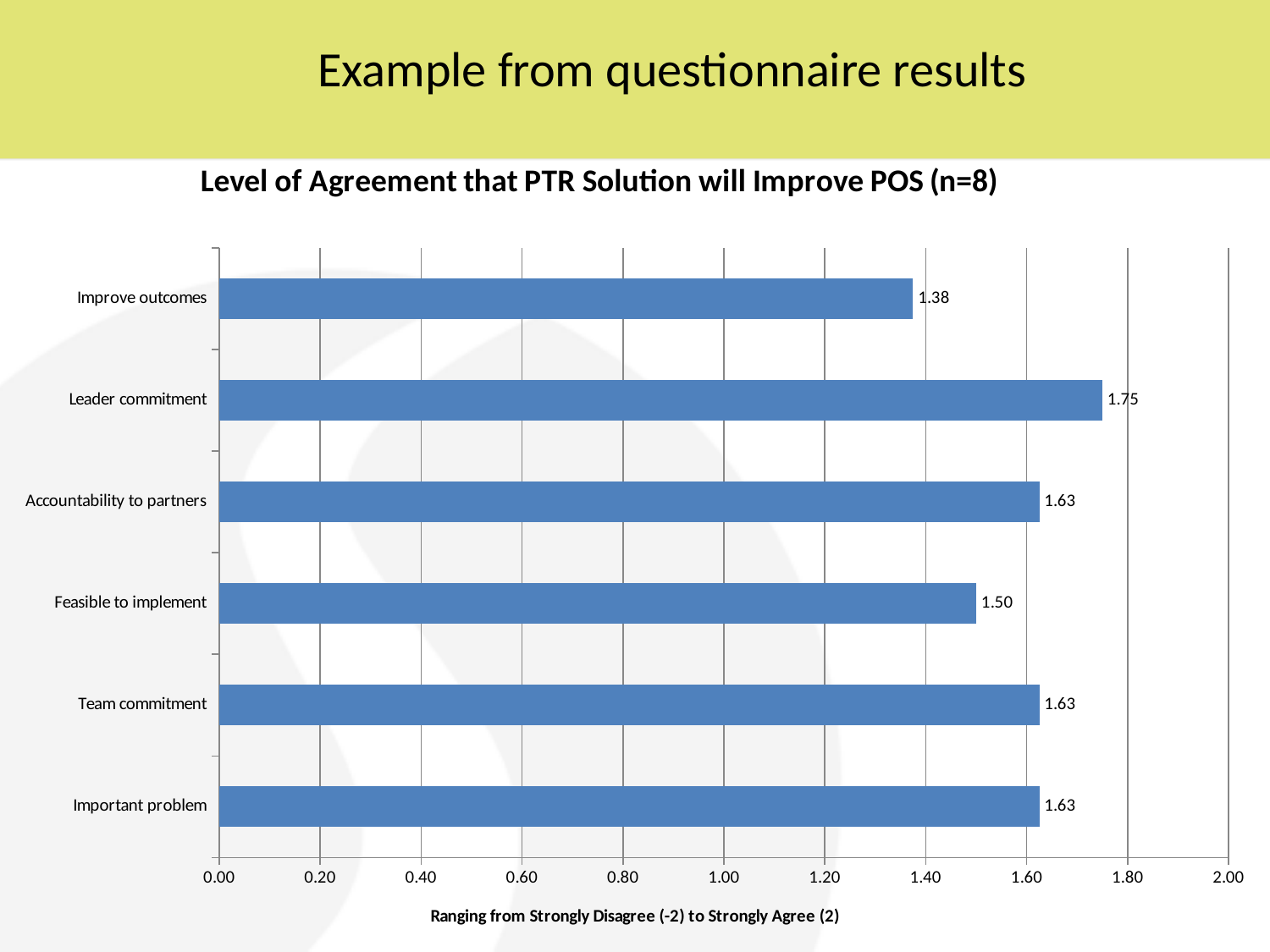
Which category has the lowest value? Improve outcomes How many categories are shown in the chart? 6 What is the title of the chart? Level of Agreement that PTR Solution will Improve POS (n=8) What is the value for Feasible to implement? 1.50 Which is larger, the value for Feasible to implement or the value for Important problem? Important problem What kind of chart is shown on the slide? Bar chart What is the value for Leader commitment? 1.75 What is the value for Accountability to partners? 1.63 What is the difference between the values for Leader commitment and Improve outcomes? 0.37 What is the value for Improve outcomes? 1.38 What is the difference between the values for Team commitment and Feasible to implement? 0.13 Which category has the highest value? Leader commitment